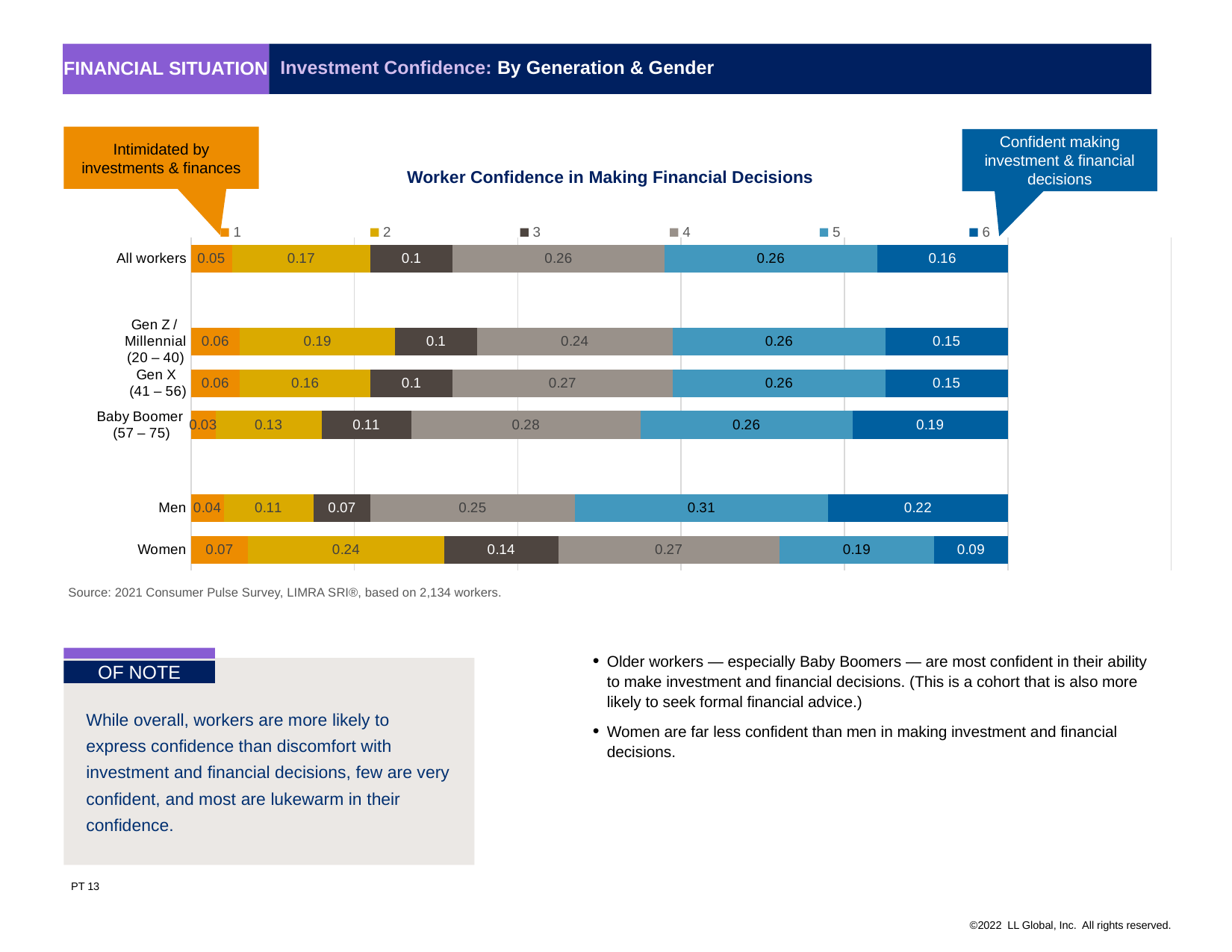
What is the title of the chart? Worker Confidence in Making Financial Decisions How many categories (bars) are plotted in the chart? 6 What kind of chart is shown on the slide? Stacked bar chart What is the value for series 1 for All workers? 0.05 What is the value for series 2 for Women? 0.24 Which category has the highest value for series 5? Men What is the difference between the series 6 values for Men and Women? 0.13 Which category has the lowest value for series 6? Women Which is larger: the series 2 value for Gen Z / Millennial (20 – 40) or for Gen X (41 – 56)? Gen Z / Millennial (20 – 40) How many series does the legend list? 6 What is the value for series 6 for Men? 0.22 What is the value for series 4 for Baby Boomer (57 – 75)? 0.28